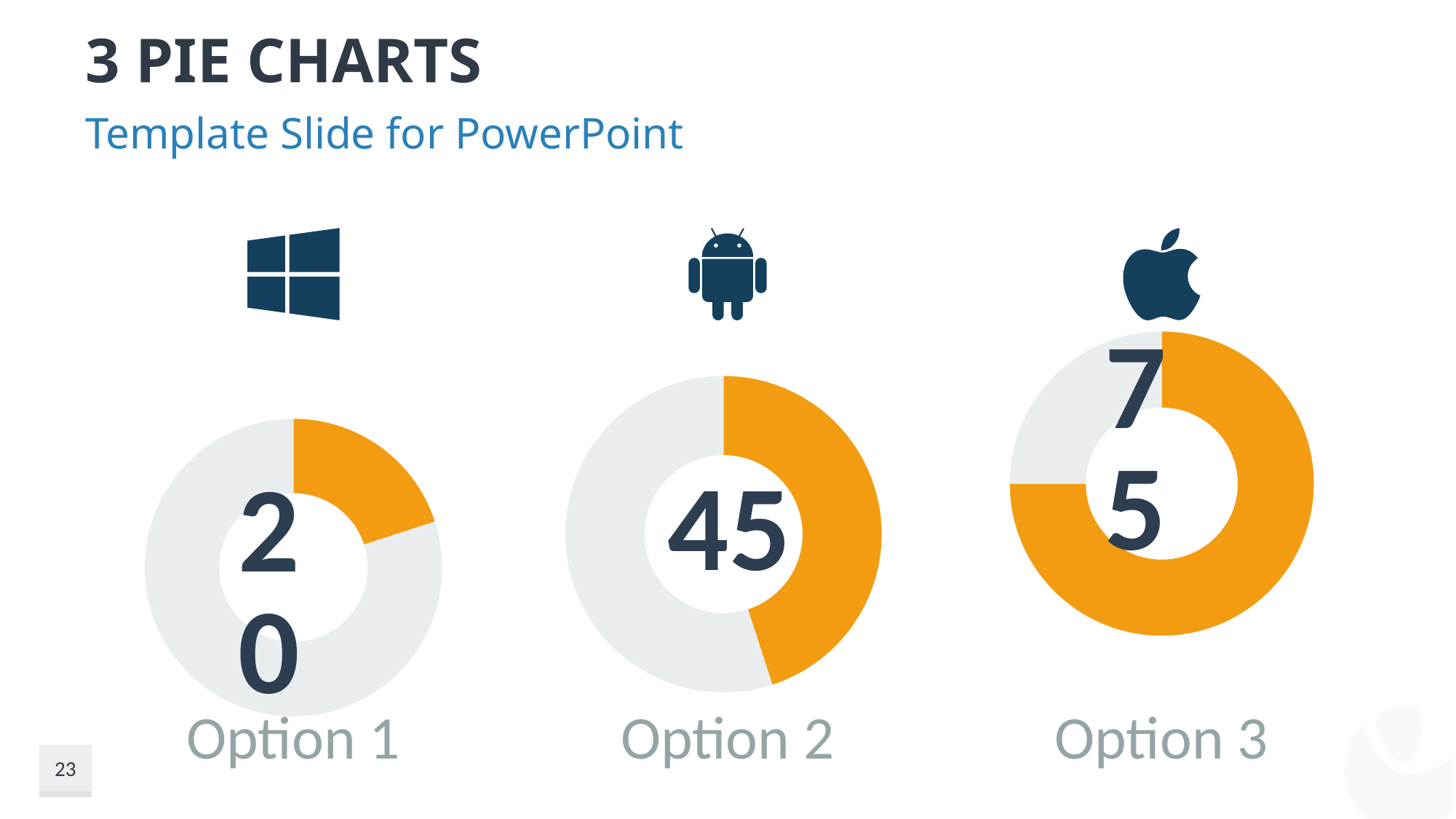
Which has the larger value, Option 2 or Option 3? Option 3 Which option has the highest value? Option 3 What colour is the highlighted slice in each chart? Orange What value is shown in the centre of the Option 2 chart? 45 What is the difference between the values for Option 3 and Option 1? 55 What value is shown in the centre of the Option 1 chart? 20 How many charts are shown on the slide? 3 What kind of chart is used for each option on this slide? Doughnut chart Which option has the lowest value? Option 1 What value is shown in the centre of the Option 3 chart? 75 Which icon appears above the Option 2 chart? Android What is the difference between the values for Option 2 and Option 1? 25